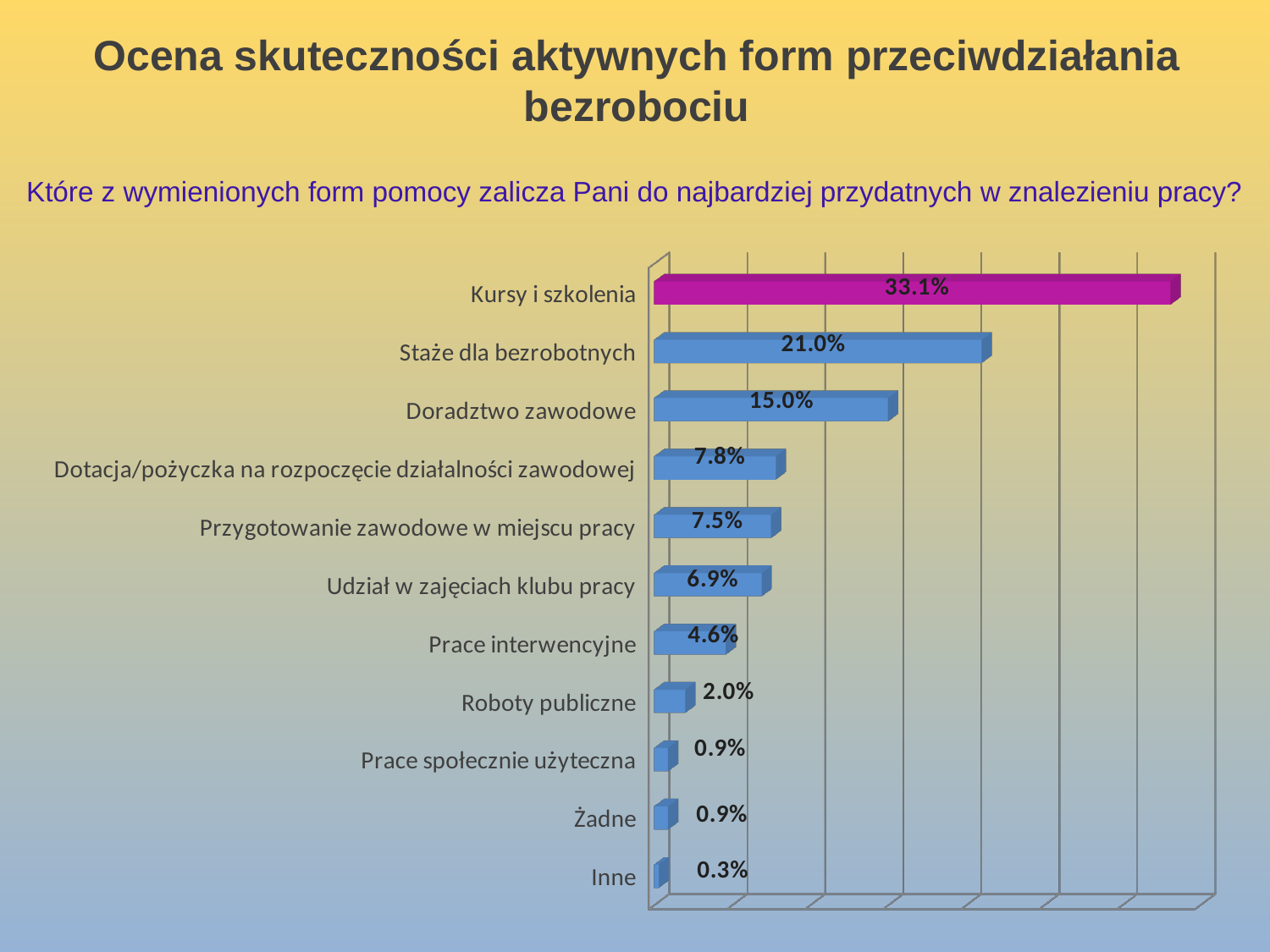
What is the value for Doradztwo zawodowe? 15.0% What is the value for Udział w zajęciach klubu pracy? 6.9% Which category has the highest value? Kursy i szkolenia What is the value for Kursy i szkolenia? 33.1% Which is larger, the value for Dotacja/pożyczka na rozpoczęcie działalności zawodowej or the value for Prace interwencyjne? Dotacja/pożyczka na rozpoczęcie działalności zawodowej What kind of chart is shown on the slide? Bar chart Which category has the lowest value? Inne How many categories are shown in the chart? 11 Which bar is coloured differently (magenta) from the others? Kursy i szkolenia What is the value for Staże dla bezrobotnych? 21.0% What is the difference between the values for Kursy i szkolenia and Staże dla bezrobotnych? 12.1% What is the value for Roboty publiczne? 2.0%